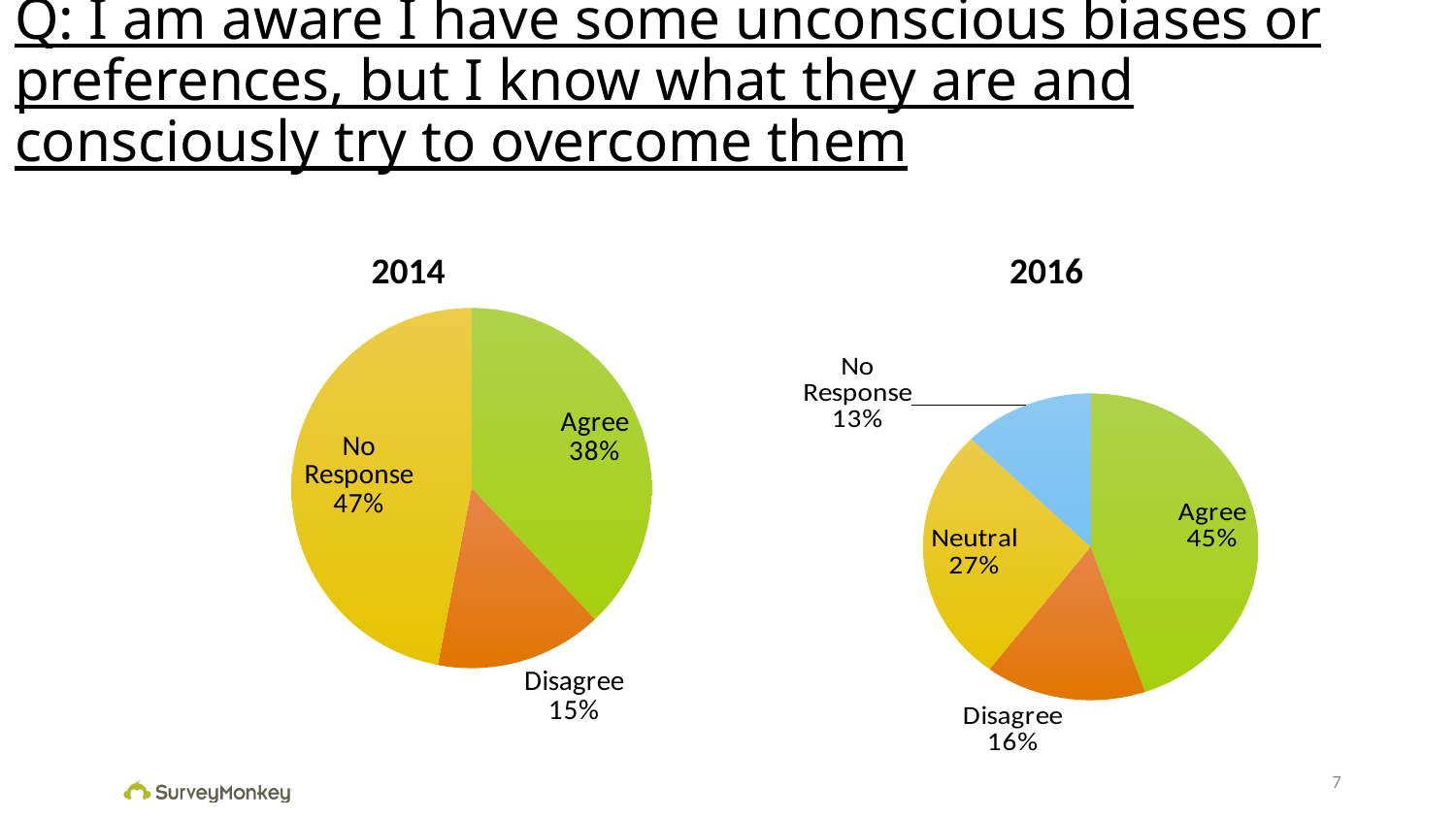
In the 2016 chart, which category has the largest share? Agree In the 2014 chart, what percentage of respondents chose Agree? 38% In the 2014 chart, what is the difference between the No Response share and the Disagree share? 32% What type of chart is used on this slide? Pie chart In the 2014 chart, what percentage is labelled No Response? 47% What is the difference between the Agree share in 2016 and the Agree share in 2014? 7% How many slices does the 2016 chart have? 4 In the 2016 chart, which category has the smallest share? No Response In the 2016 chart, what percentage of respondents chose Neutral? 27% Which is larger: the Disagree share in 2014 or the Disagree share in 2016? 2016 In the 2014 chart, which category has the largest share? No Response In the 2016 chart, what percentage of respondents chose Disagree? 16%